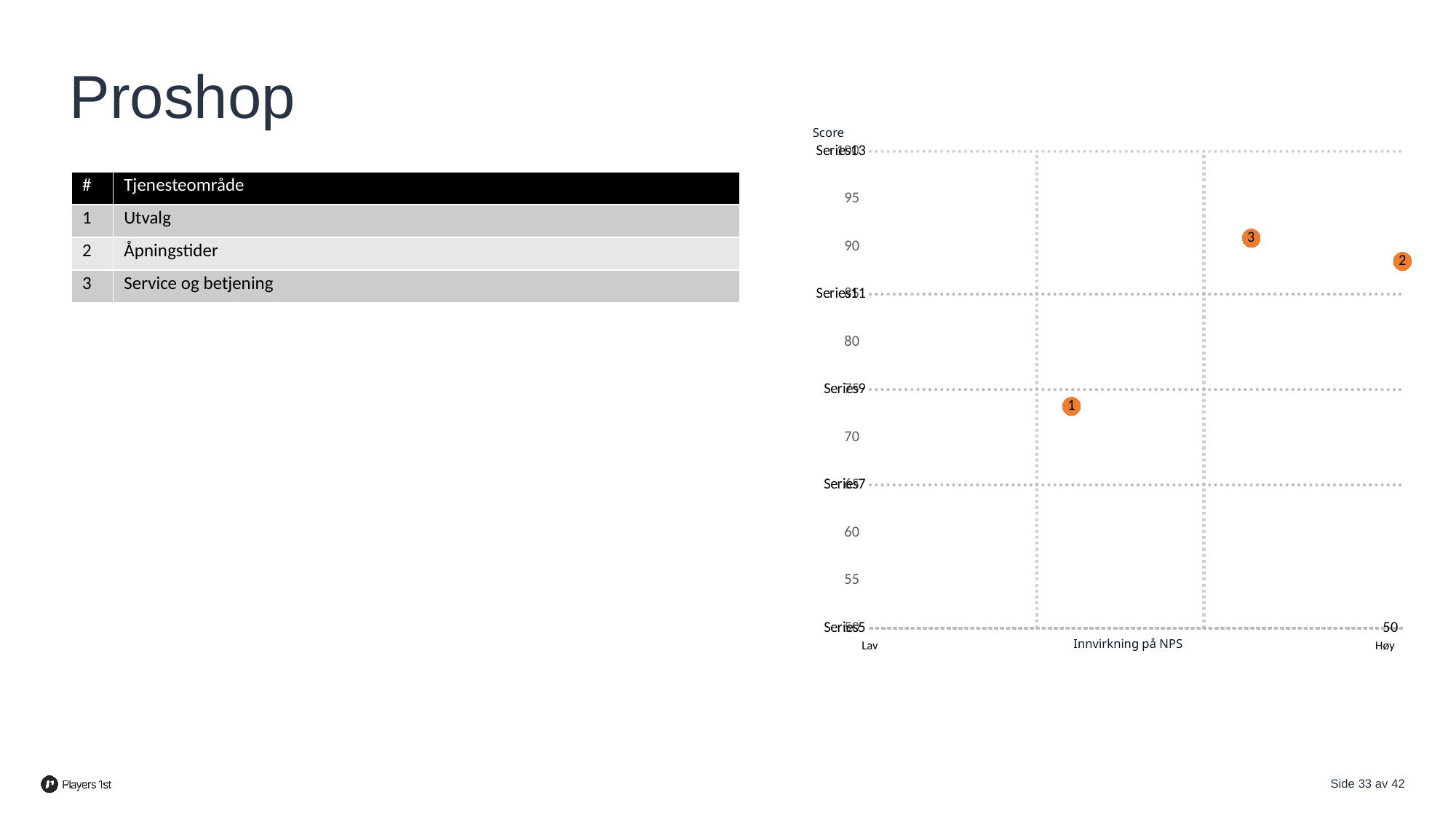
Is the Score for point 3 greater or less than 85? greater How many data points are plotted on the chart? 3 Which numbered point is furthest to the left (lowest Innvirkning på NPS)? 1 What is the label of the vertical axis of the chart? Score Which numbered point has the lowest Score on the chart? 1 Is the Score for point 1 greater or less than 75? less Which has a higher Score, point 1 or point 3? point 3 Which numbered point is furthest to the right (highest Innvirkning på NPS)? 2 What kind of chart is shown on the right of the slide? scatter chart Is the Score for point 2 greater or less than 80? greater What is the label of the horizontal axis of the chart? Innvirkning på NPS